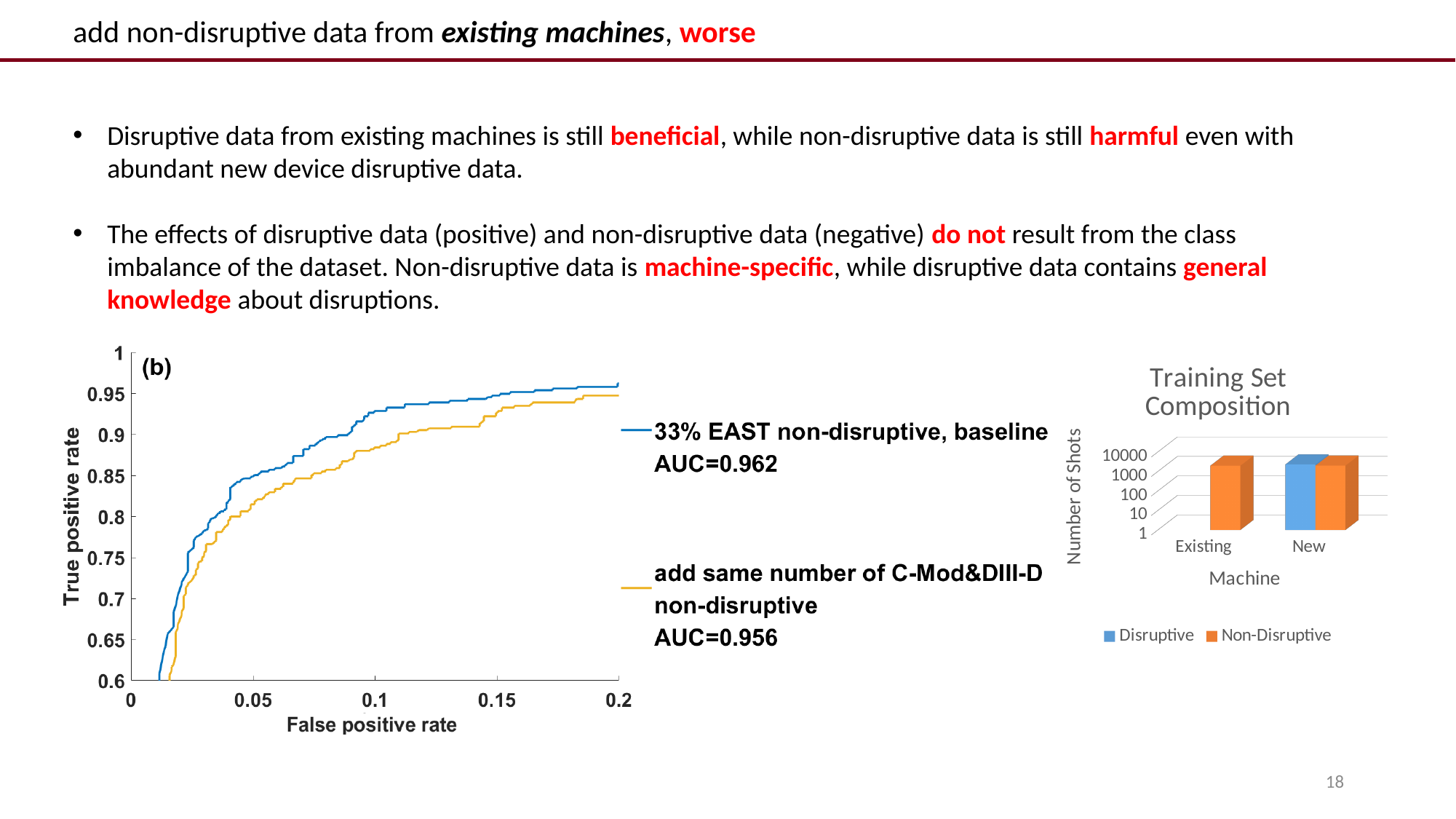
In the chart labelled (b), what is the difference between the two AUC values? 0.006 In the chart labelled (b), what is the label of the x axis? False positive rate How many machine categories are shown on the x axis of the 'Training Set Composition' chart? 2 In the chart labelled (b), what is the AUC for the 'add same number of C-Mod&DIII-D non-disruptive' curve? 0.956 In the chart labelled (b), how many curves are plotted? 2 In the chart labelled (b), what is the AUC for the '33% EAST non-disruptive, baseline' curve? 0.962 In the chart labelled (b), which curve has the higher AUC? 33% EAST non-disruptive, baseline In the chart labelled (b), does the true positive rate rise or fall as the false positive rate increases? rise What kind of chart is the 'Training Set Composition' chart? bar chart How many series does the legend of the 'Training Set Composition' chart list? 2 What kind of chart is the chart on the left labelled (b)? line chart In the 'Training Set Composition' chart, is the Non-Disruptive value for Existing greater or less than 100? greater